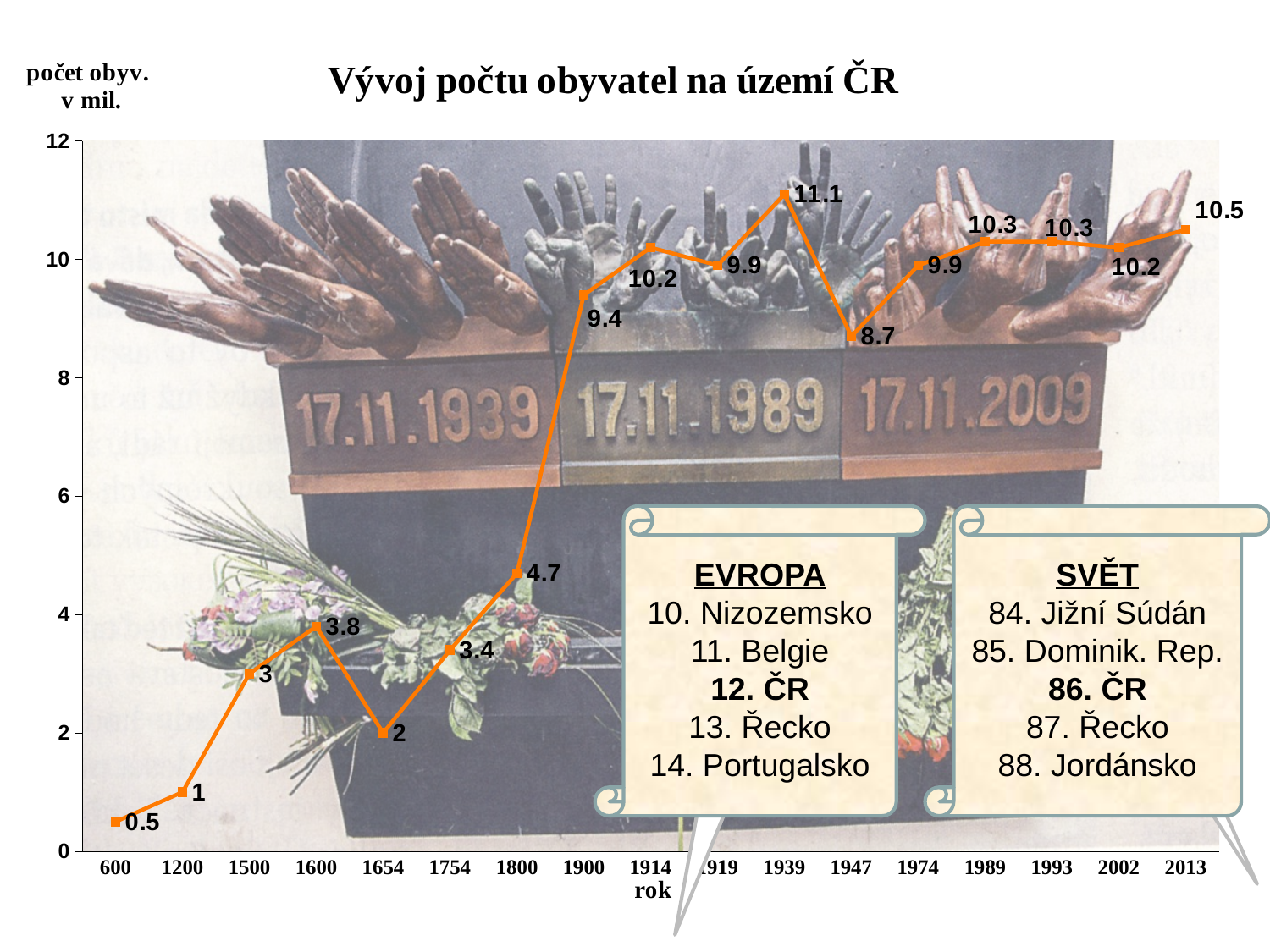
What is the value plotted for the year 1654? 2 What type of chart is shown on the slide? line chart Does the value rise or fall between 1800 and 1900? rise Which year has the lowest plotted value? 600 What is the title of the chart? Vývoj počtu obyvatel na území ČR Which year has the highest plotted value? 1939 What is the difference between the values for 1939 and 1947? 2.4 What is the value plotted for the year 2013? 10.5 What is the label of the x axis? rok How many data points are plotted on the line? 17 What is the value plotted for the year 1939? 11.1 Which is larger, the value for 1600 or the value for 1754? 1600